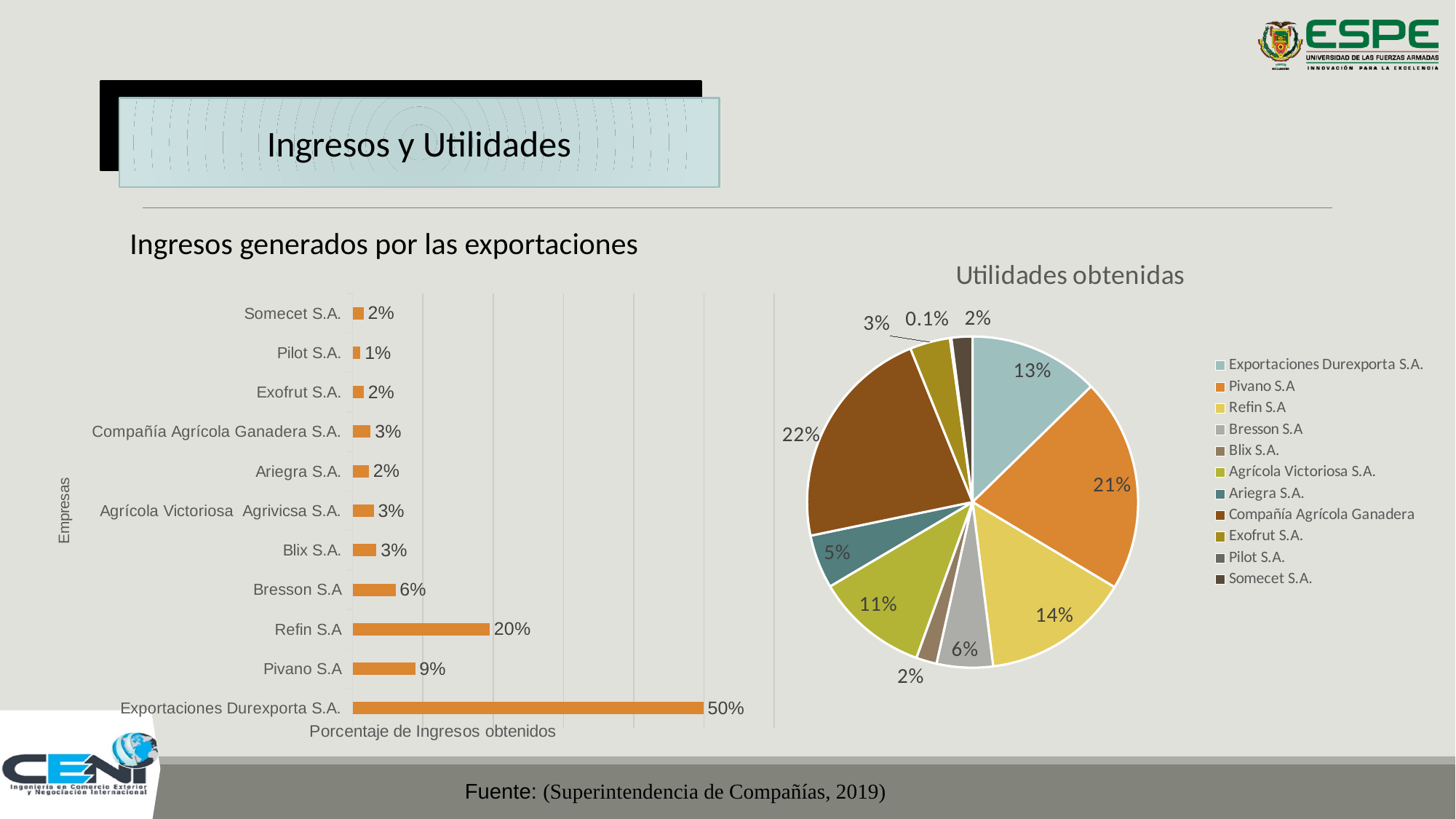
In the bar chart 'Ingresos generados por las exportaciones', which company has the highest percentage of income? Exportaciones Durexporta S.A. In the bar chart 'Ingresos generados por las exportaciones', which company has the lowest percentage of income? Pilot S.A. In the bar chart 'Ingresos generados por las exportaciones', which is larger, Pivano S.A or Bresson S.A? Pivano S.A In the pie chart 'Utilidades obtenidas', what share does Compañía Agrícola Ganadera have? 22% How many entries does the legend of the pie chart 'Utilidades obtenidas' list? 11 How many companies are shown in the bar chart 'Ingresos generados por las exportaciones'? 11 In the bar chart 'Ingresos generados por las exportaciones', what is the difference between Exportaciones Durexporta S.A. and Refin S.A? 30% In the pie chart 'Utilidades obtenidas', what is the difference between Pivano S.A and Refin S.A? 7% In the bar chart 'Ingresos generados por las exportaciones', what is the value for Refin S.A? 20% In the pie chart 'Utilidades obtenidas', what is the value for Pilot S.A.? 0.1% What type of chart is 'Ingresos generados por las exportaciones'? Bar chart In the pie chart 'Utilidades obtenidas', which company has the largest slice? Compañía Agrícola Ganadera